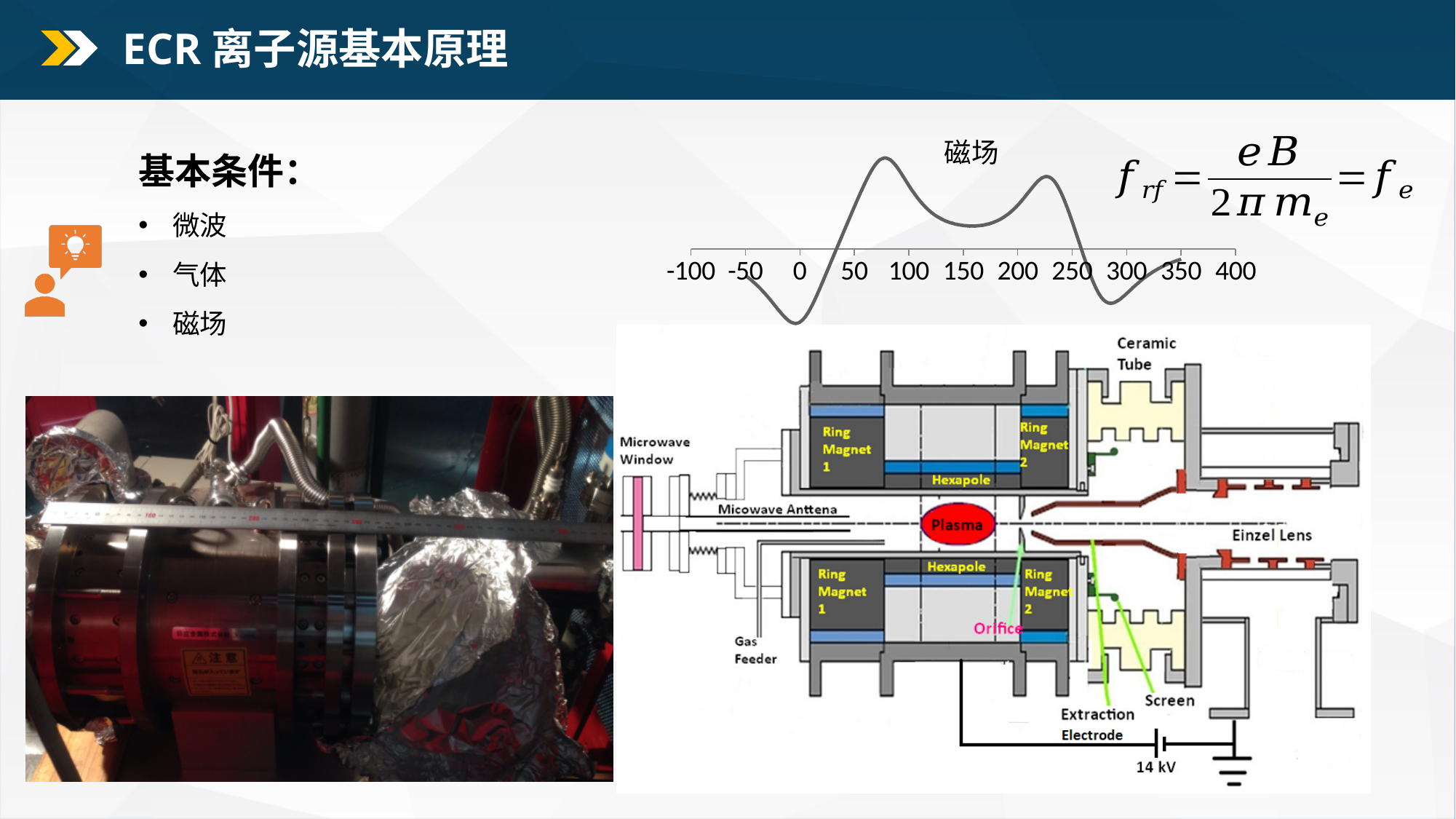
On the 磁场 chart, is the line higher at x = 50 or at x = -50? x = 50 On the 磁场 chart, how many peaks (local maxima) does the line have? 2 On the 磁场 chart, does the line rise or fall as x goes from 250 to 300? fall How many tick labels are shown on the x axis of the 磁场 chart? 11 On the 磁场 chart, what is the spacing between consecutive x-axis tick labels? 50 On the 磁场 chart, does the line rise or fall as x goes from 0 to 50? rise On the 磁场 chart, does the line rise or fall as x goes from 100 to 150? fall What kind of chart is the 磁场 chart at the top right of the slide? line chart On the 磁场 chart, what is the largest value labelled on the x axis? 400 On the 磁场 chart, what is the smallest value labelled on the x axis? -100 What is the title of the line chart at the top right of the slide? 磁场